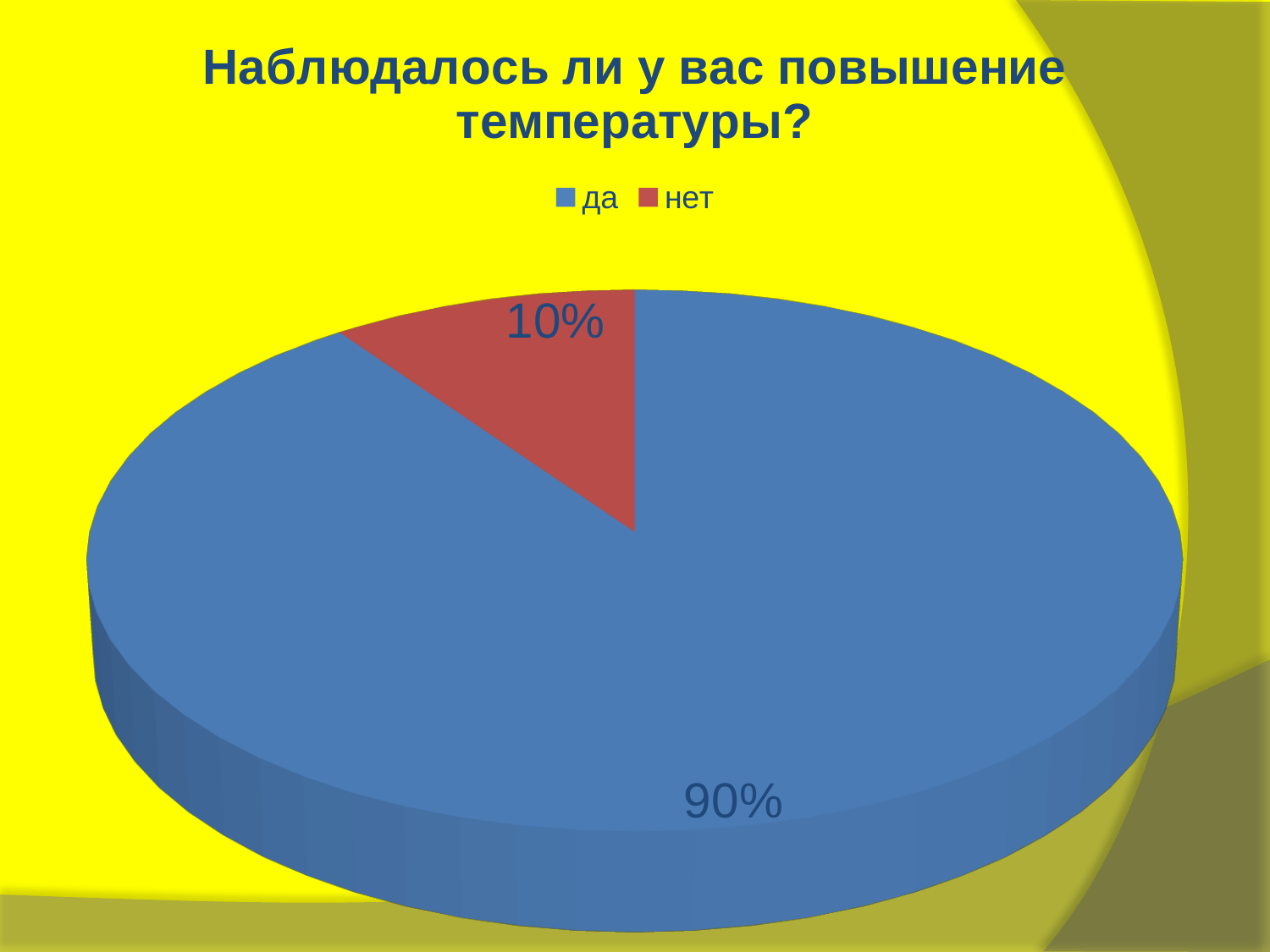
What kind of chart is shown on the slide? pie chart What is the difference in percentage points between the "да" and "нет" slices? 80% What colour is the "нет" slice? red What share of the pie does the "нет" slice represent? 10% Which category has the smallest slice of the pie? нет How many categories does the pie chart show? 2 What is the title of the chart? Наблюдалось ли у вас повышение температуры? Which category has the largest slice of the pie? да How many entries does the legend list? 2 Which slice is larger, "да" or "нет"? да What share of the pie does the "да" slice represent? 90%